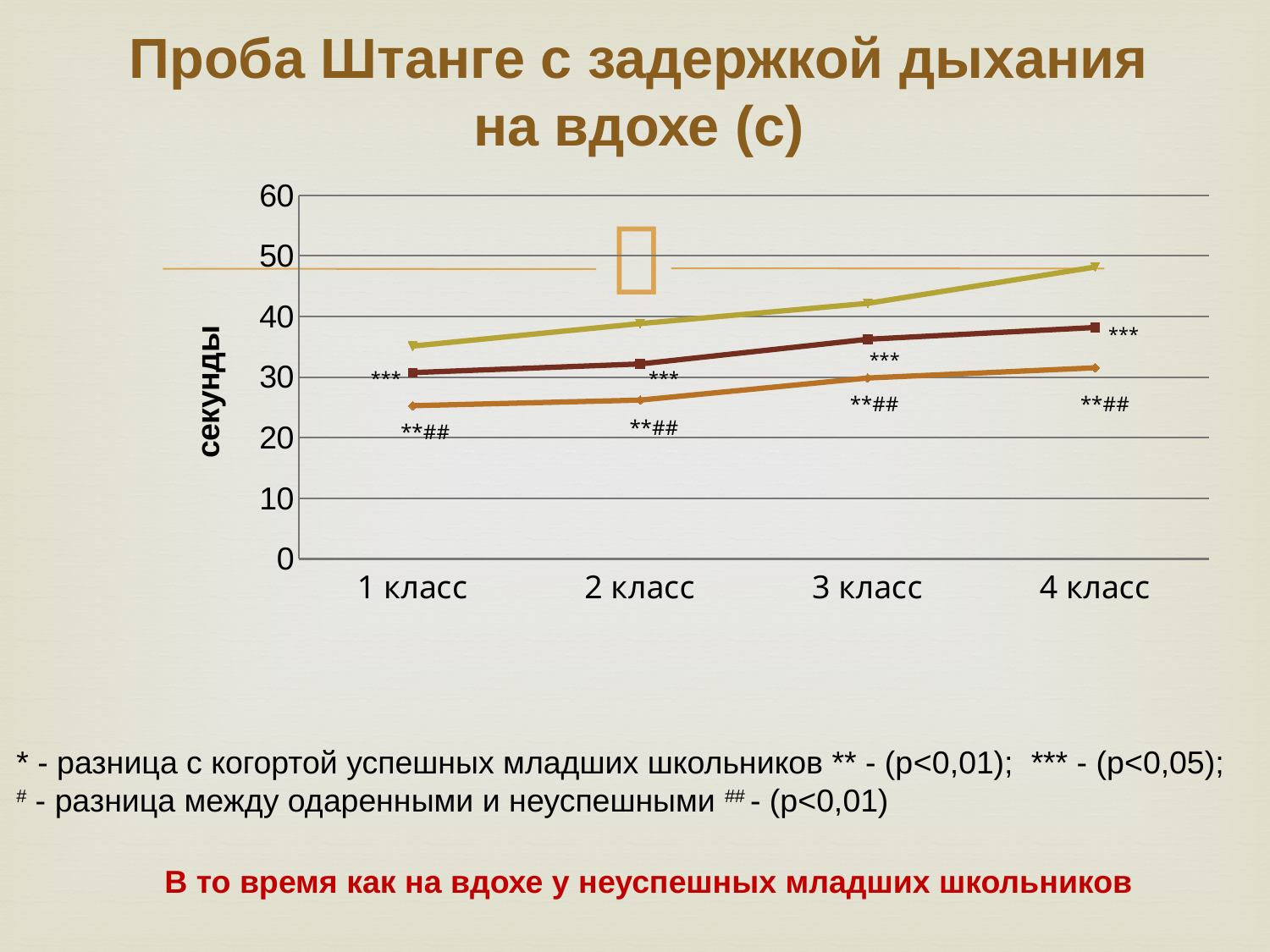
What is the label of the vertical axis of the chart? секунды How many categories are shown on the x axis of the chart? 4 Do the values of the bottom (orange) line rise or fall from 1 класс to 4 класс? rise Is the value of the top (yellow-olive) line at 1 класс greater or less than 30? greater At 4 класс, which line has the larger value: the yellow-olive line or the orange line? the yellow-olive line Is the value of the dark brown line at 4 класс greater or less than 40? less How many lines are plotted on the chart? 3 Is the value of the top (yellow-olive) line at 4 класс greater or less than 40? greater Do the values of the top (yellow-olive) line rise or fall from 1 класс to 4 класс? rise What is the title of the chart on the slide? Проба Штанге с задержкой дыхания на вдохе (с) What kind of chart is shown on the slide? line chart